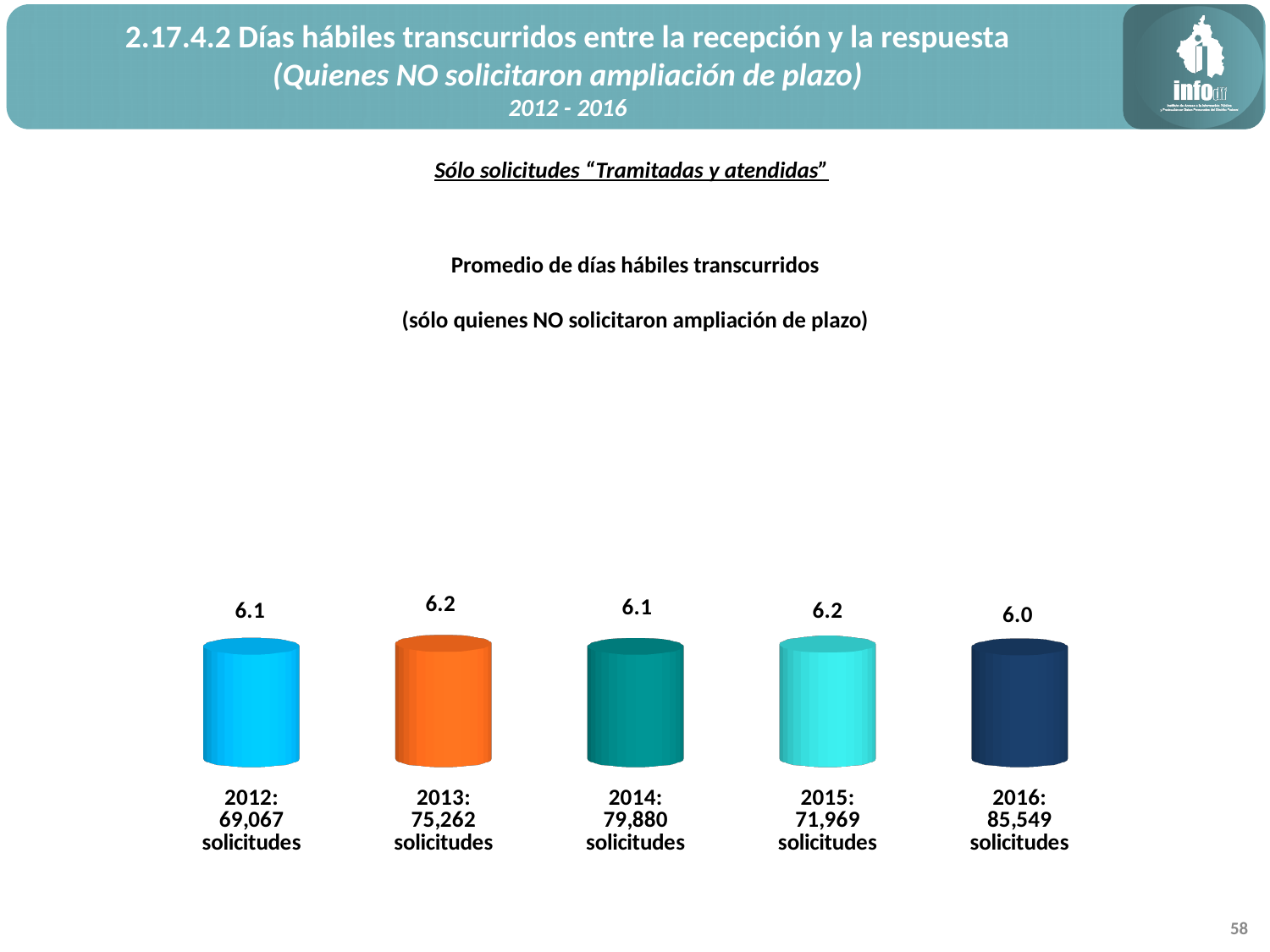
Which year has the lowest average number of business days in the chart? 2016 What is the difference between the average business days for 2013 and 2016? 0.2 What is the average number of business days shown for 2016? 6.0 Which is larger, the average business days for 2015 or for 2016? 2015 How many years (categories) are plotted in the chart? 5 What is the average number of business days (promedio de días hábiles transcurridos) shown for 2012? 6.1 What is the average number of business days shown for 2014? 6.1 How many solicitudes are indicated in the category label for 2016? 85,549 solicitudes What kind of chart is shown on the slide? Bar chart What is the title printed above the chart? Promedio de días hábiles transcurridos (sólo quienes NO solicitaron ampliación de plazo) What is the average number of business days shown for 2013? 6.2 What is the average number of business days shown for 2015? 6.2